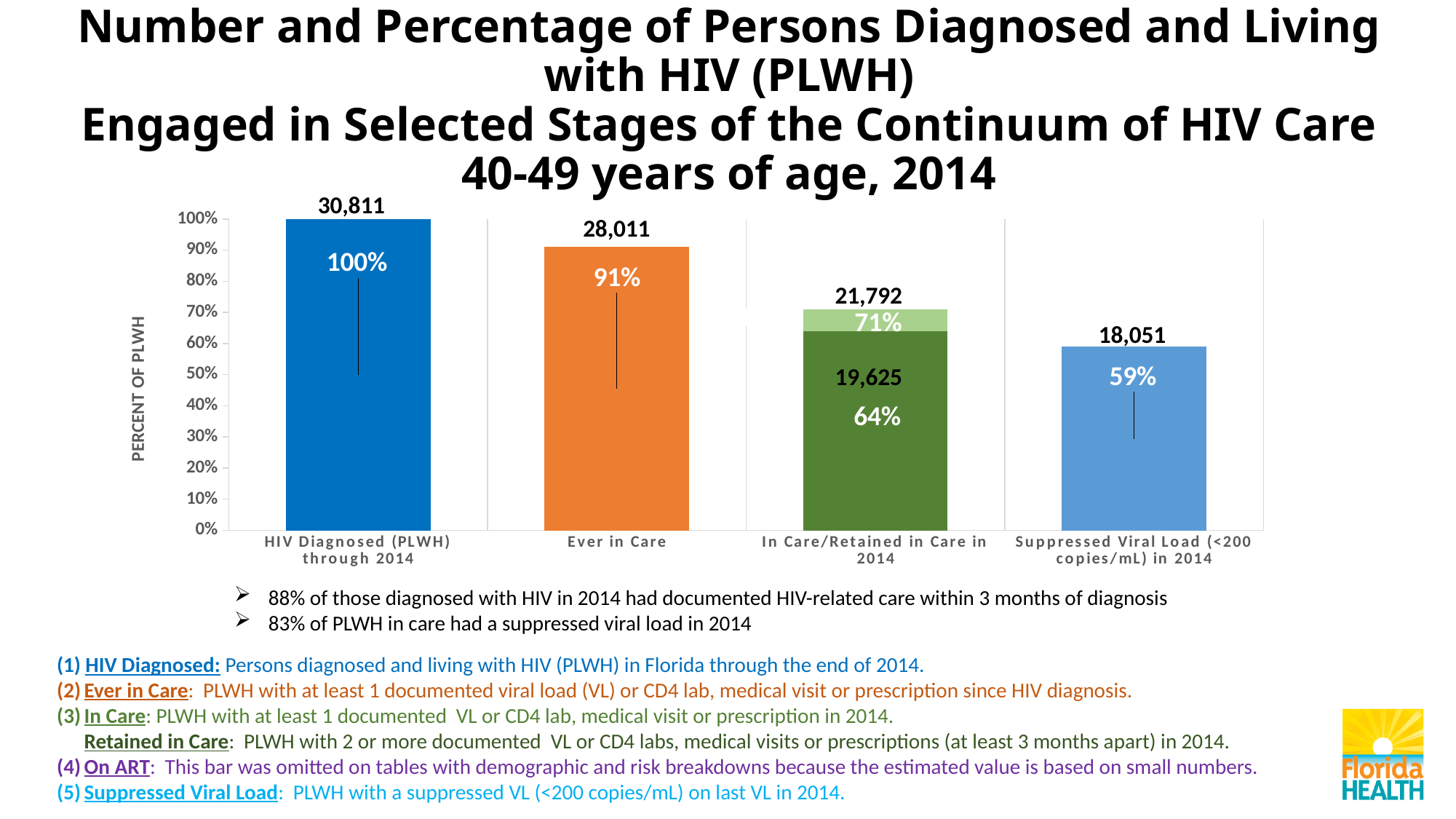
How many stages of the continuum of care are shown on the x axis? 4 What is the difference in percentage points between Ever in Care and Suppressed Viral Load (<200 copies/mL) in 2014? 32 Which stage has the highest number of persons? HIV Diagnosed (PLWH) through 2014 What percentage is shown for the Ever in Care bar? 91% What number is shown for the HIV Diagnosed (PLWH) through 2014 bar? 30,811 Which is larger, the number for Ever in Care or the number for In Care/Retained in Care in 2014? Ever in Care What percentage is shown for the Retained in Care (dark green) portion of the In Care/Retained in Care in 2014 bar? 64% Which stage has the lowest percentage of PLWH? Suppressed Viral Load (<200 copies/mL) in 2014 What kind of chart is shown on the slide? Bar chart What number is shown for the Suppressed Viral Load (<200 copies/mL) in 2014 bar? 18,051 What is the difference in number of persons between HIV Diagnosed (PLWH) through 2014 and Ever in Care? 2,800 What number is shown above the In Care/Retained in Care in 2014 bar? 21,792